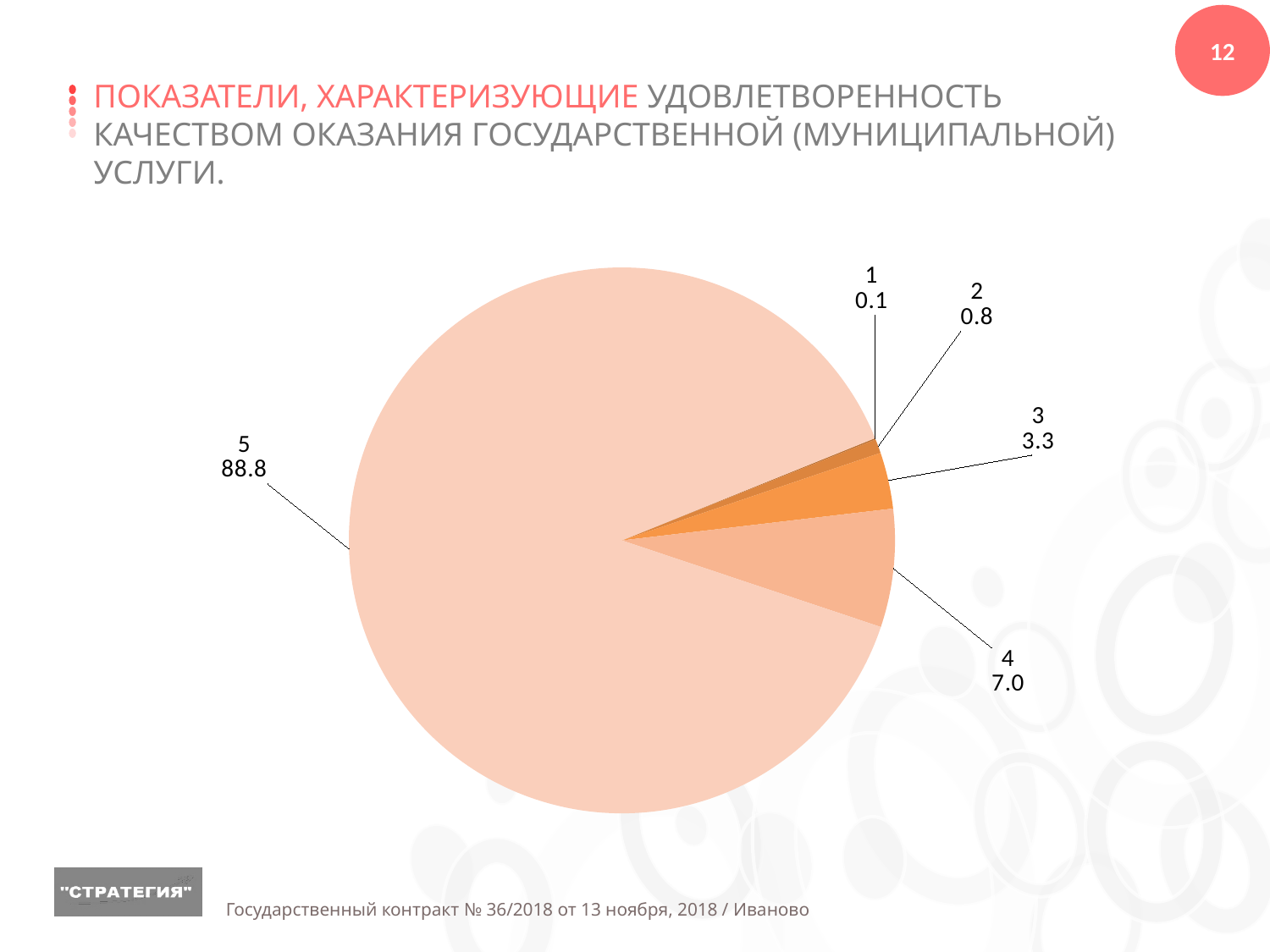
What is the total of all the values shown in the pie chart? 100.0 What is the difference between the values for category 5 and category 4? 81.8 What is the difference between the values for category 4 and category 3? 3.7 How many categories are shown in the pie chart? 5 What kind of chart is shown on the slide? pie chart What is the value for category 4 in the pie chart? 7.0 Which category has the largest slice of the pie chart? 5 Which category has the smallest slice of the pie chart? 1 What is the value for category 5 in the pie chart? 88.8 What is the value for category 3 in the pie chart? 3.3 Which is larger, the value for category 2 or the value for category 3? 3 What is the value for category 1 in the pie chart? 0.1